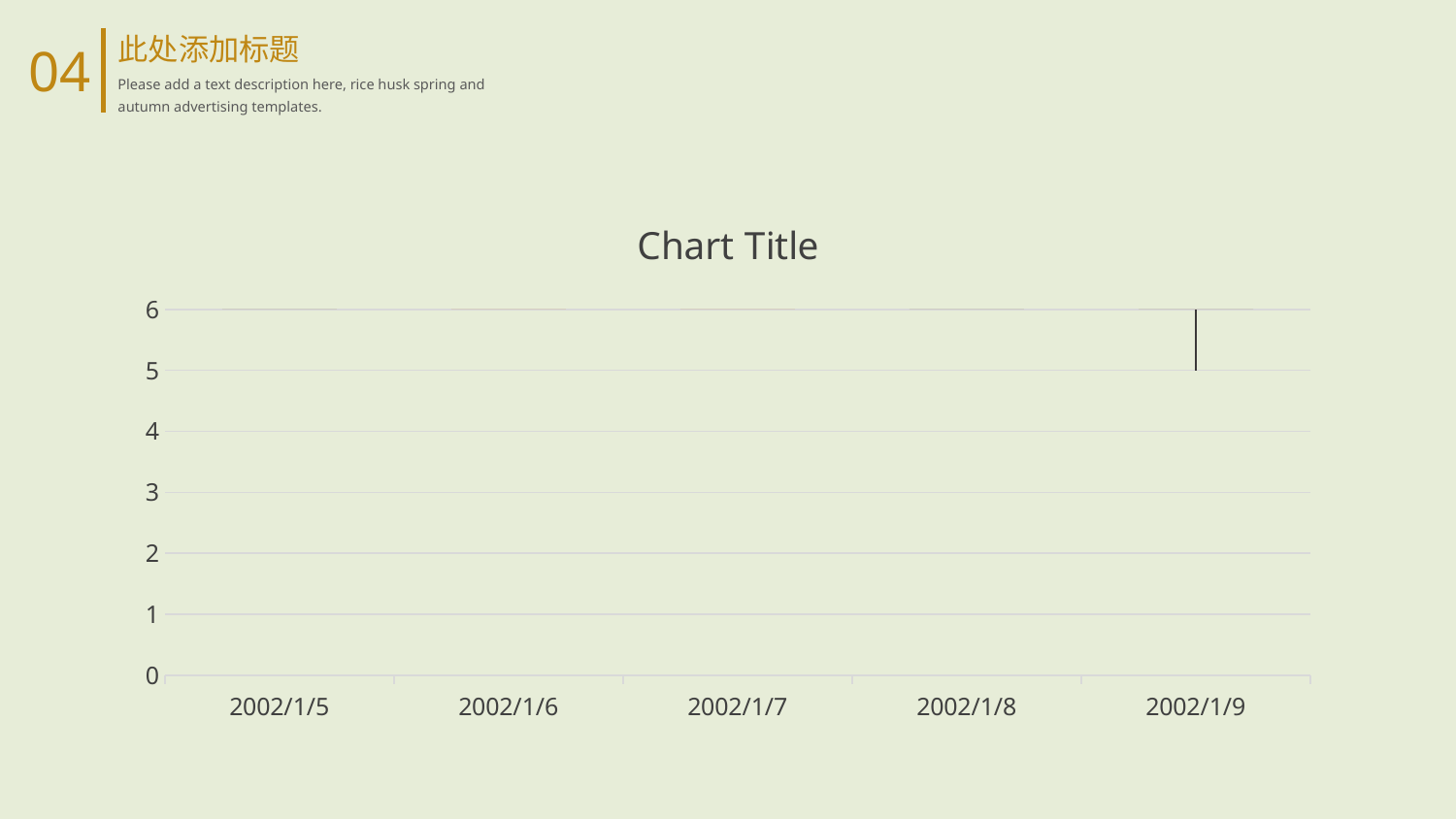
What is the title of the chart? Chart Title What is the first date label on the x axis of the chart? 2002/1/5 How many dates are shown along the x axis of the chart? 5 Is the value plotted for 2002/1/9 greater or less than 4? greater What is the highest tick value shown on the y axis of the chart? 6